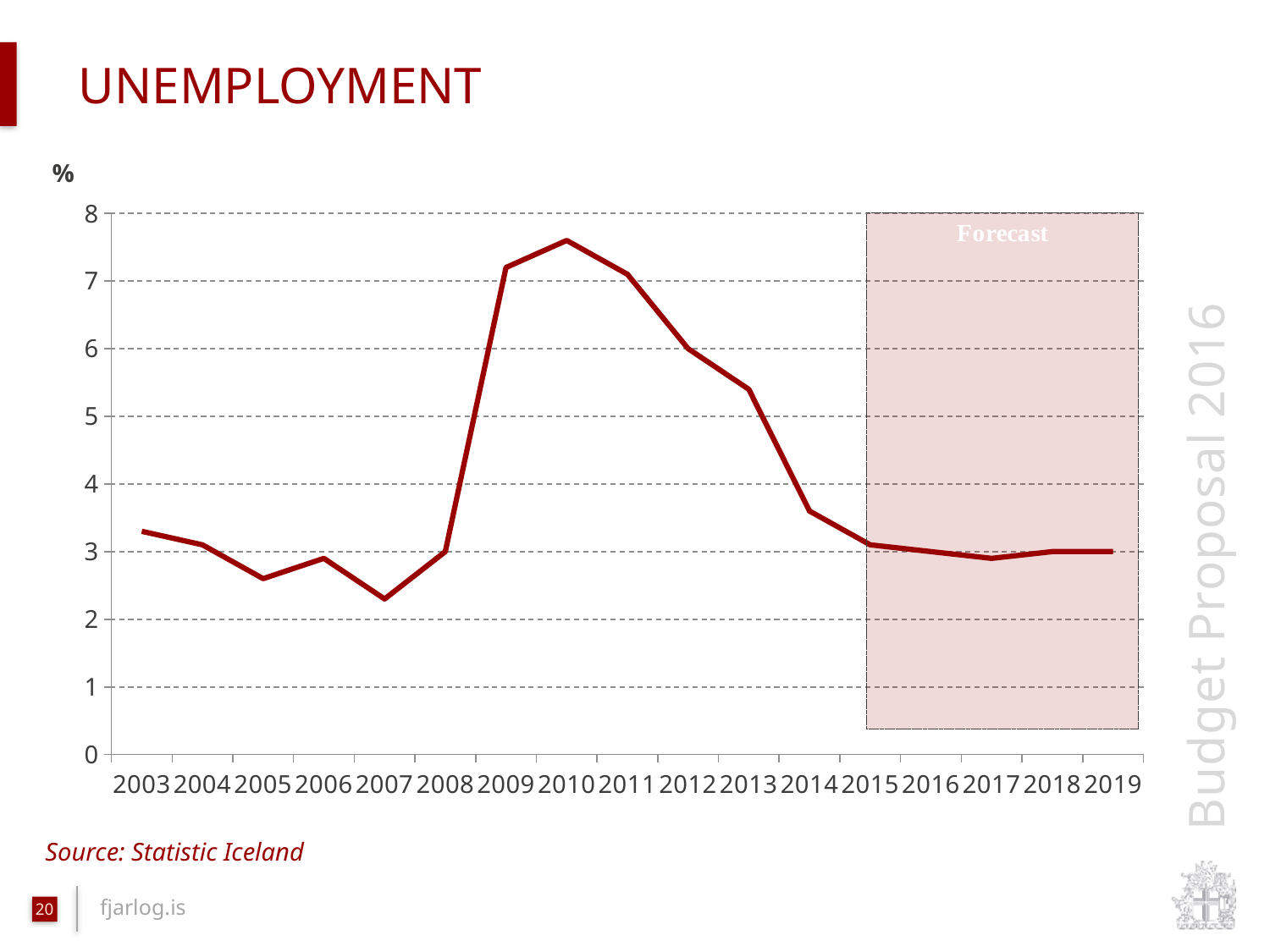
Which year has a higher unemployment rate, 2009 or 2014? 2009 How many years are shown on the x axis? 17 Which year has the highest unemployment rate? 2010 Is the unemployment value for 2007 greater or less than 3? less Is the unemployment value for 2014 greater or less than 4? less Which year has the lowest unemployment rate? 2007 From which year does the shaded forecast region begin? 2015 Is the unemployment value for 2005 greater or less than 3? less Does unemployment rise or fall from 2010 to 2014? fall What kind of chart is shown on the slide? line chart